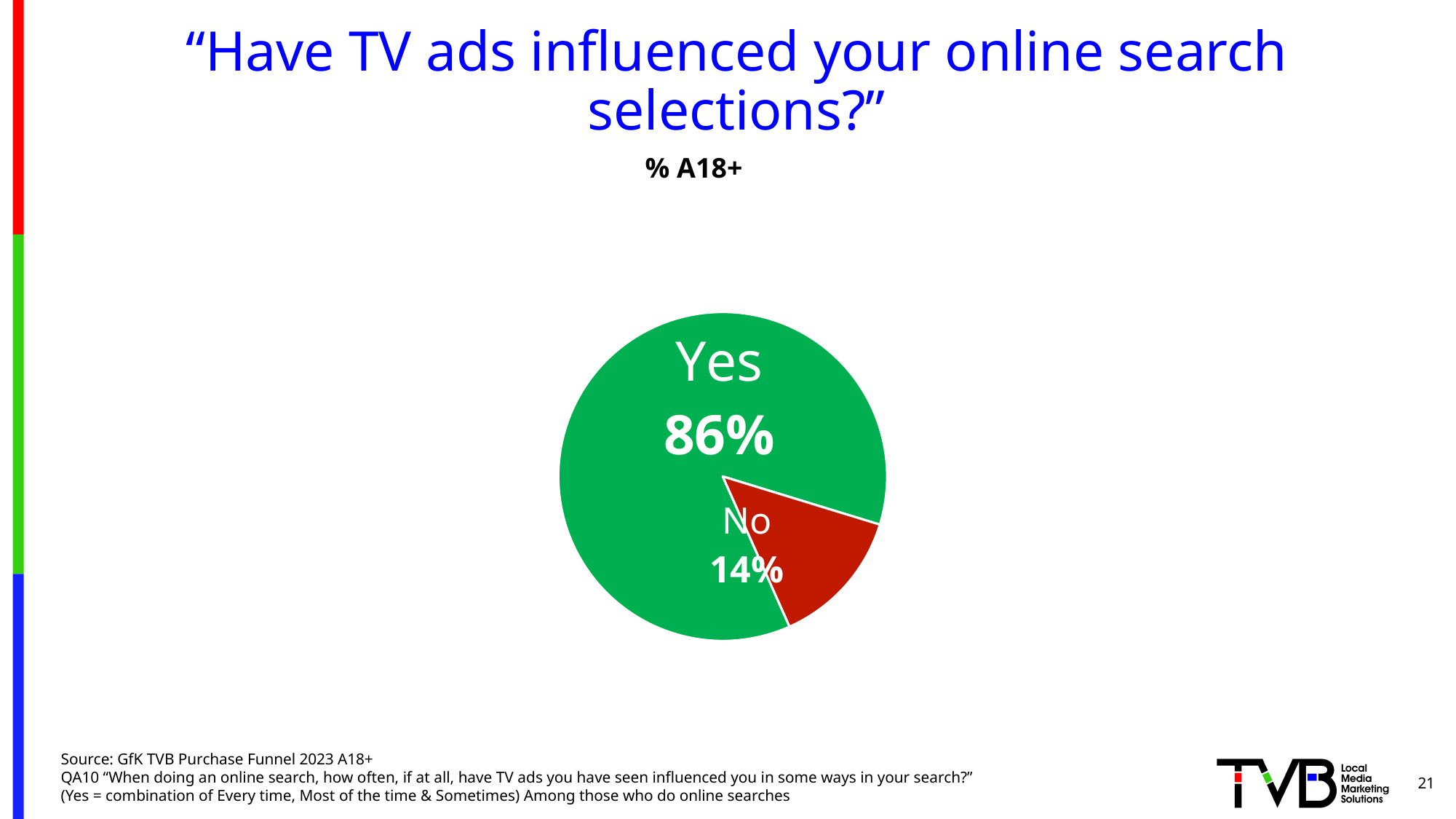
What share of the pie does the "No" slice represent? 14% What is the subtitle shown above the pie chart? % A18+ What kind of chart is shown on the slide? pie chart Which response has the smallest share of the pie? No What colour is the "Yes" slice of the pie? green How many slices does the pie chart have? 2 What percentage of respondents answered "Yes"? 86% Which slice is larger, "Yes" or "No"? Yes Which response has the largest share of the pie? Yes What is the difference in percentage points between the "Yes" and "No" slices? 72 What percentage of respondents answered "No"? 14%